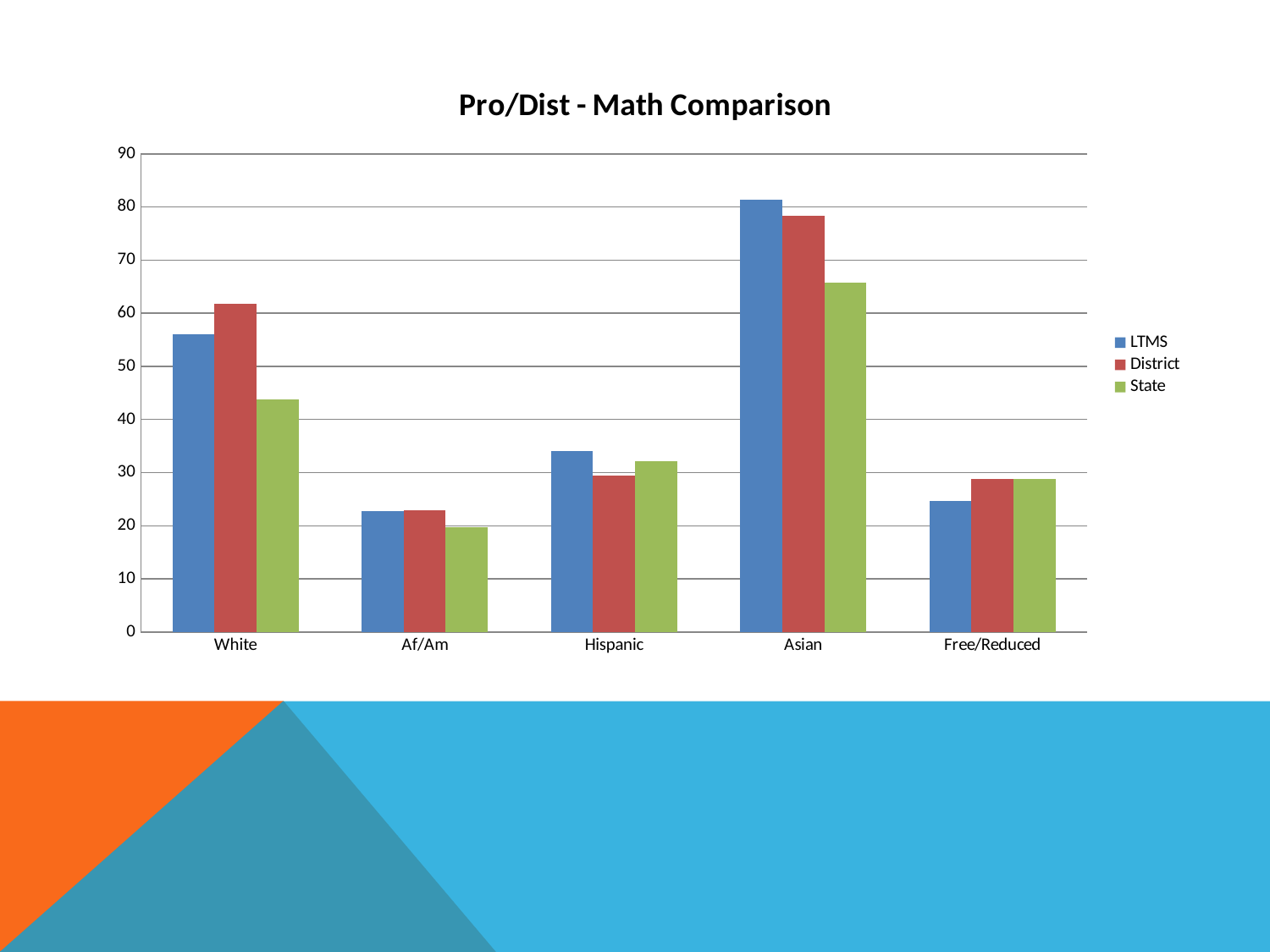
How many series does the legend list? 3 How many categories are shown on the x axis of the chart? 5 For the Hispanic category, which is larger: the LTMS value or the District value? LTMS What kind of chart is shown on the slide? bar chart Is the State value for Asian greater or less than 60? greater For the White category, which is larger: the LTMS value or the District value? District Which category has the lowest State value? Af/Am Which colour represents the State series in the legend? green Is the LTMS value for Free/Reduced greater or less than 30? less What is the title of the chart? Pro/Dist - Math Comparison Which category has the highest LTMS value? Asian Is the State value for White greater or less than 50? less